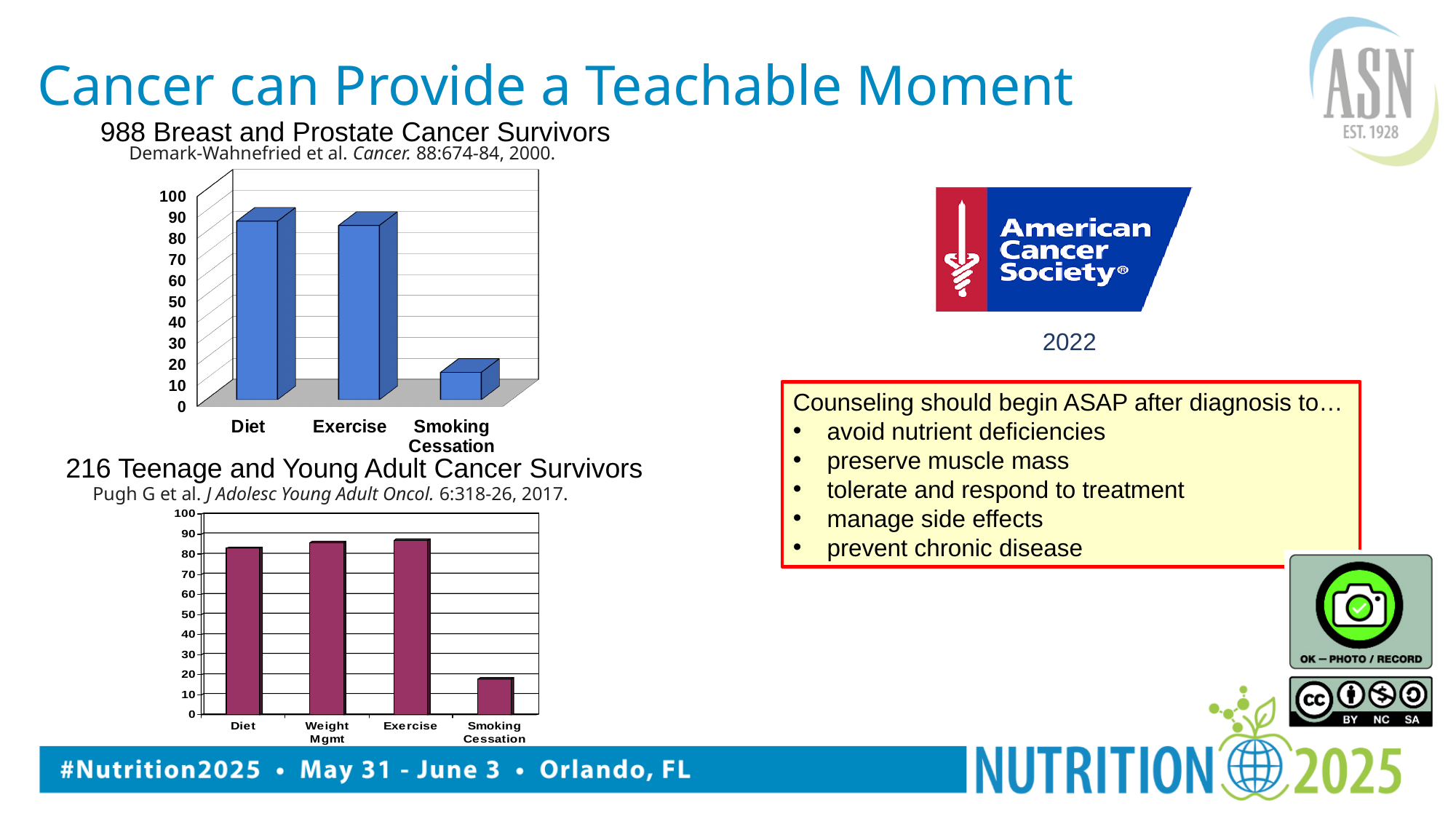
In the '988 Breast and Prostate Cancer Survivors' chart, do the values rise or fall from left to right along the x axis? fall In the '216 Teenage and Young Adult Cancer Survivors' chart, which is larger, the value for Diet or the value for Smoking Cessation? Diet In the '216 Teenage and Young Adult Cancer Survivors' chart, which category has the lowest value? Smoking Cessation In the '988 Breast and Prostate Cancer Survivors' chart, which category has the lowest value? Smoking Cessation What kind of chart is the '988 Breast and Prostate Cancer Survivors' chart? bar chart In the '216 Teenage and Young Adult Cancer Survivors' chart, is the value for Smoking Cessation greater or less than 30? less How many categories are shown in the '988 Breast and Prostate Cancer Survivors' chart? 3 In the '988 Breast and Prostate Cancer Survivors' chart, is the value for Smoking Cessation greater or less than 30? less In the '988 Breast and Prostate Cancer Survivors' chart, is the value for Diet greater or less than 80? greater How many categories are shown in the '216 Teenage and Young Adult Cancer Survivors' chart? 4 What kind of chart is the '216 Teenage and Young Adult Cancer Survivors' chart? bar chart